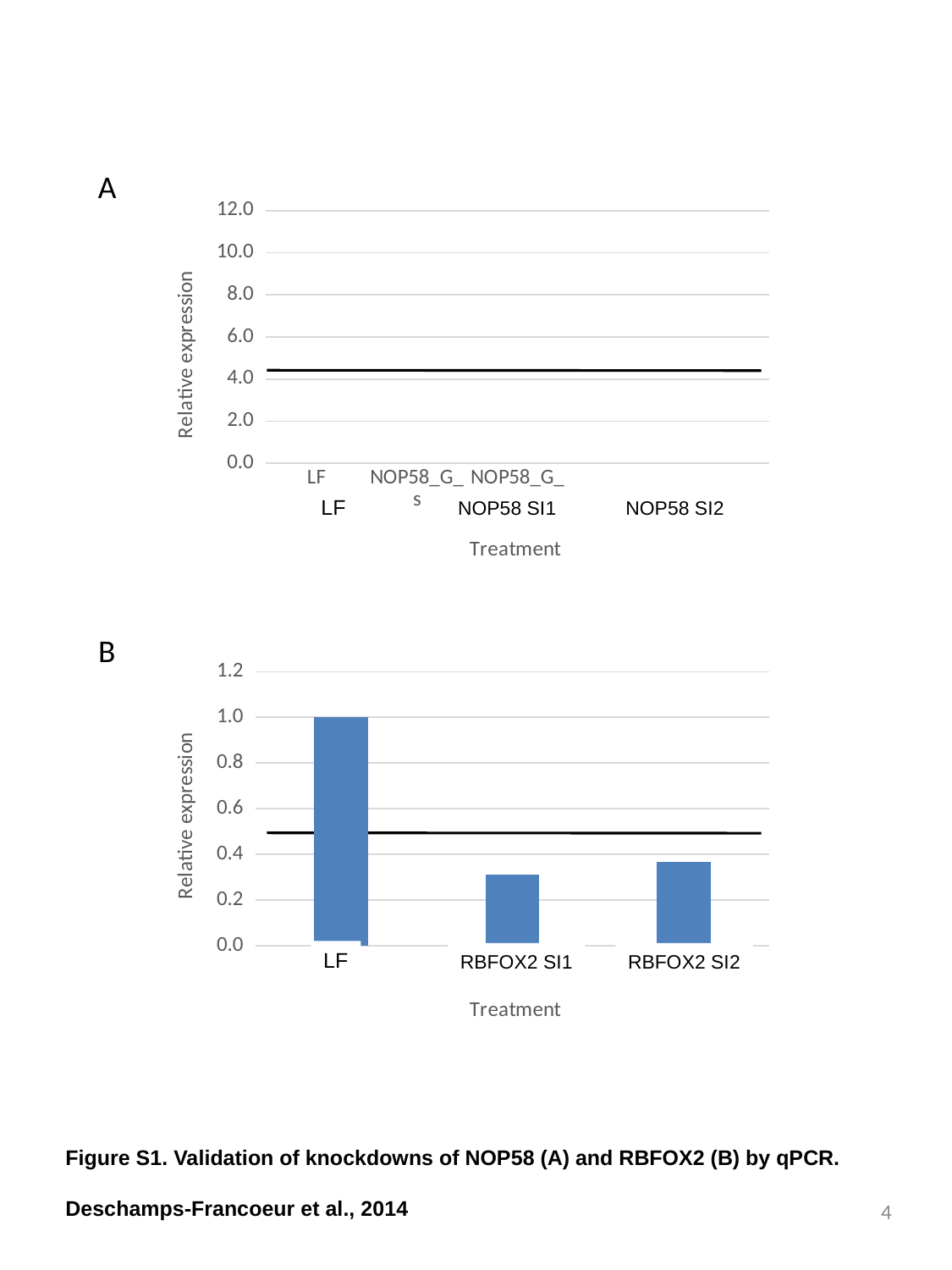
What is the y-axis title of chart A (top)? Relative expression In chart B (bottom), is the value for RBFOX2 SI2 greater or less than 0.6? less In chart B (bottom), is the value for RBFOX2 SI1 greater or less than 0.4? less In chart B (bottom), which treatment has the highest relative expression? LF What is the x-axis title of chart B (bottom)? Treatment In chart B (bottom), which treatment has the lowest relative expression? RBFOX2 SI1 In chart B (bottom), is the value for RBFOX2 SI1 greater or less than 0.2? greater In chart B (bottom), what is the relative expression value for LF? 1.0 In chart B (bottom), which has the larger relative expression, RBFOX2 SI1 or RBFOX2 SI2? RBFOX2 SI2 In chart B (bottom), how many treatment categories are shown on the x axis? 3 In chart A (top), how many treatment categories are labelled on the x axis? 3 What kind of chart is chart B (bottom)? bar chart